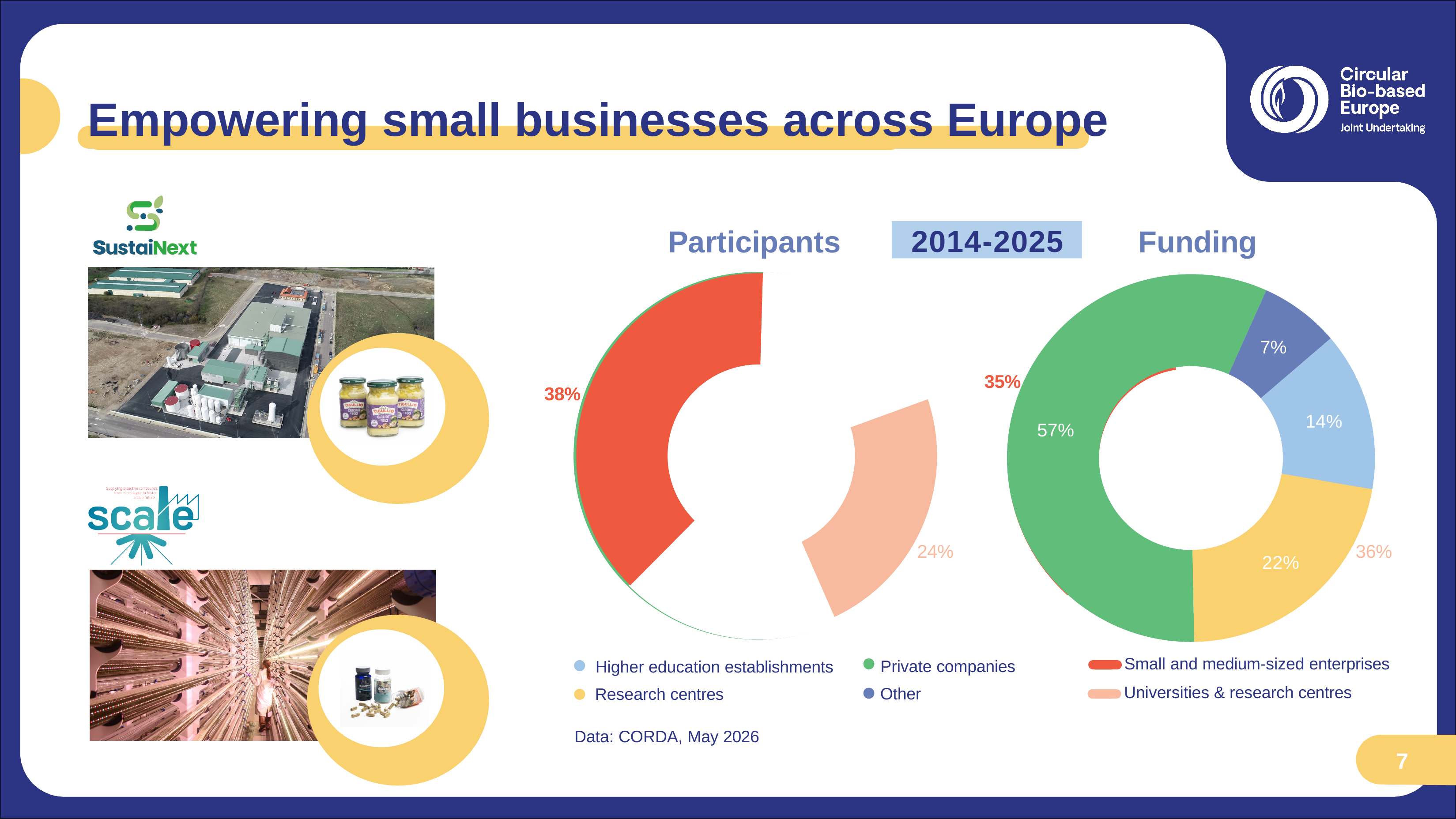
In the Funding chart, which category has the smallest share? Other What type of chart is used for the Participants and Funding visuals? Donut (pie) chart In the Funding chart, what share is shown for small and medium-sized enterprises? 35% In the Funding chart, which is larger: the share for research centres or for higher education establishments? Research centres In the Funding chart, what share is shown for private companies? 57% In the Funding chart, what share is shown for the 'Other' category? 7% In the Funding chart, what share is shown for higher education establishments? 14% In the Participants chart, how many percentage points higher is the share for small and medium-sized enterprises than for universities & research centres? 14 percentage points In the Participants chart, what share is shown for small and medium-sized enterprises? 38% In the Funding chart, which category has the largest share? Private companies In the Funding chart, what share is shown for research centres? 22% In the Participants chart, what share is shown for universities & research centres? 24%